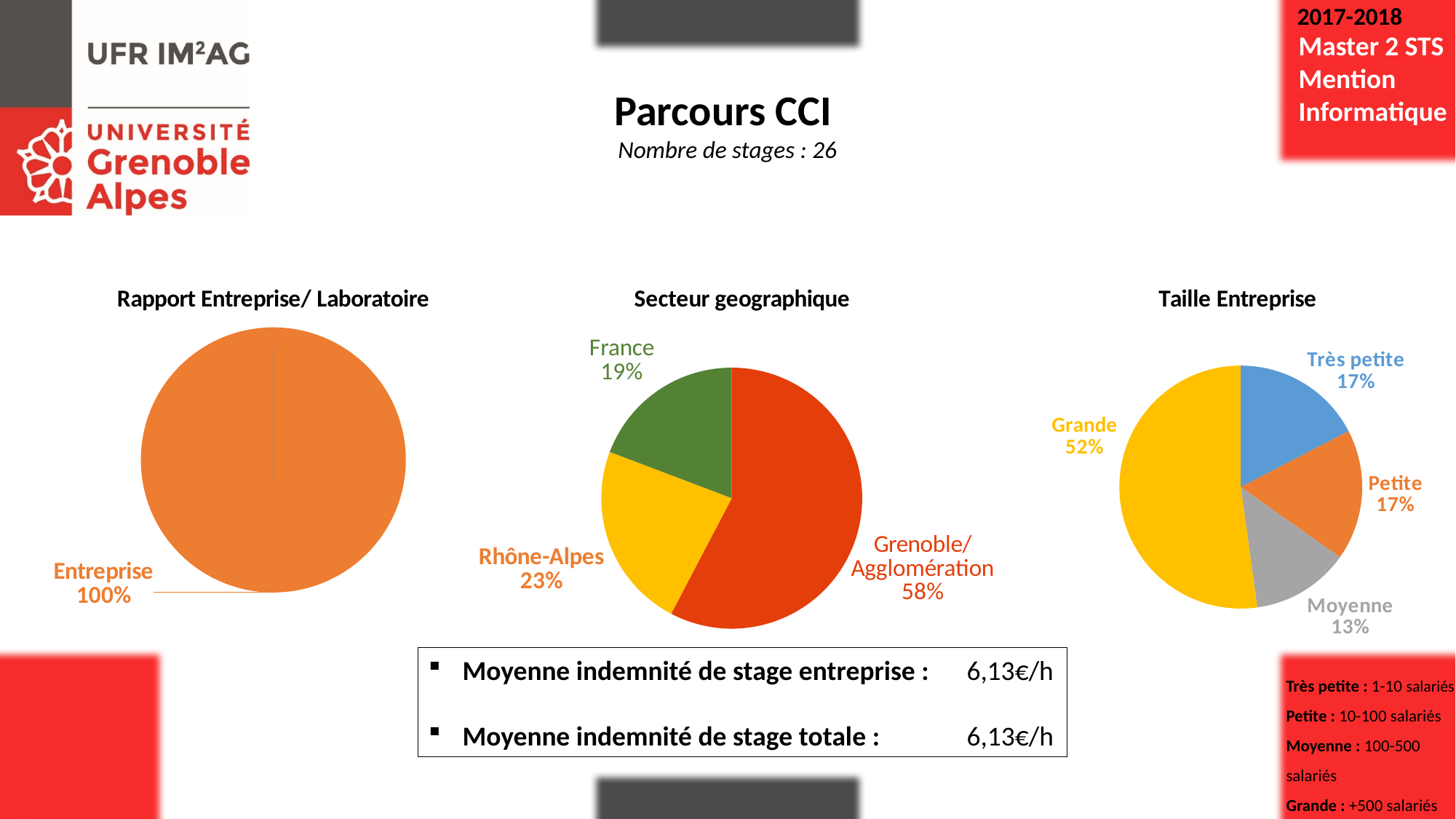
In the "Secteur geographique" chart, what is the difference between Rhône-Alpes and France? 4% In the "Secteur geographique" chart, what is the value for France? 19% In the "Taille Entreprise" chart, what is the difference between Grande and Petite? 35% In the "Secteur geographique" chart, what share does Grenoble/Agglomération have? 58% In the "Taille Entreprise" chart, how many categories are shown? 4 In the "Secteur geographique" chart, which category has the largest share? Grenoble/Agglomération In the "Taille Entreprise" chart, which category has the smallest share? Moyenne In the "Secteur geographique" chart, which category has the smallest share? France In the "Taille Entreprise" chart, what is the value for Moyenne? 13% What kind of chart is the "Secteur geographique" chart? Pie chart In the "Taille Entreprise" chart, what is the value for Grande? 52% In the "Rapport Entreprise/ Laboratoire" chart, what share does Entreprise have? 100%